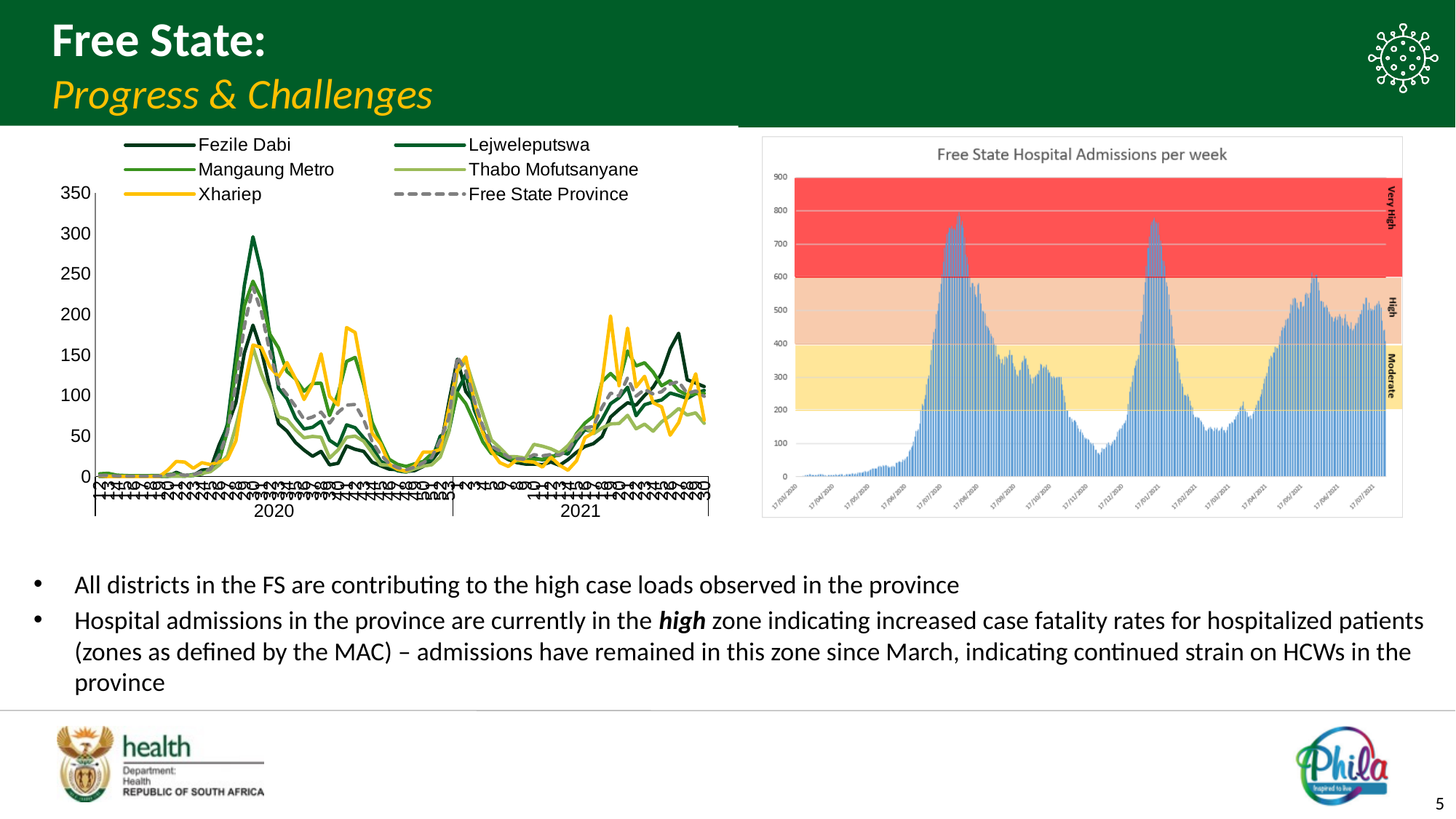
In the left-hand district chart, at the 2020 peak, which is higher: Fezile Dabi or Xhariep? Fezile Dabi What kind of chart is the left-hand chart showing the Free State districts? line chart In the Free State Hospital Admissions per week chart, are admissions around 17/11/2020 greater or less than 200? less In the left-hand district chart, which series reaches the highest peak in 2020? Lejweleputswa In the Free State Hospital Admissions per week chart, is the highest weekly admissions value greater or less than 700? greater What are the names of the three shaded zones on the Free State Hospital Admissions per week chart? Very High, High, Moderate What is the title of the right-hand chart? Free State Hospital Admissions per week In the left-hand district chart, is the highest 2021 value for Xhariep greater or less than 150? greater In the Free State Hospital Admissions per week chart, do admissions rise or fall between 17/03/2020 and 17/07/2020? rise What kind of chart is the Free State Hospital Admissions per week chart? bar chart How many series does the legend of the left-hand district chart list? 6